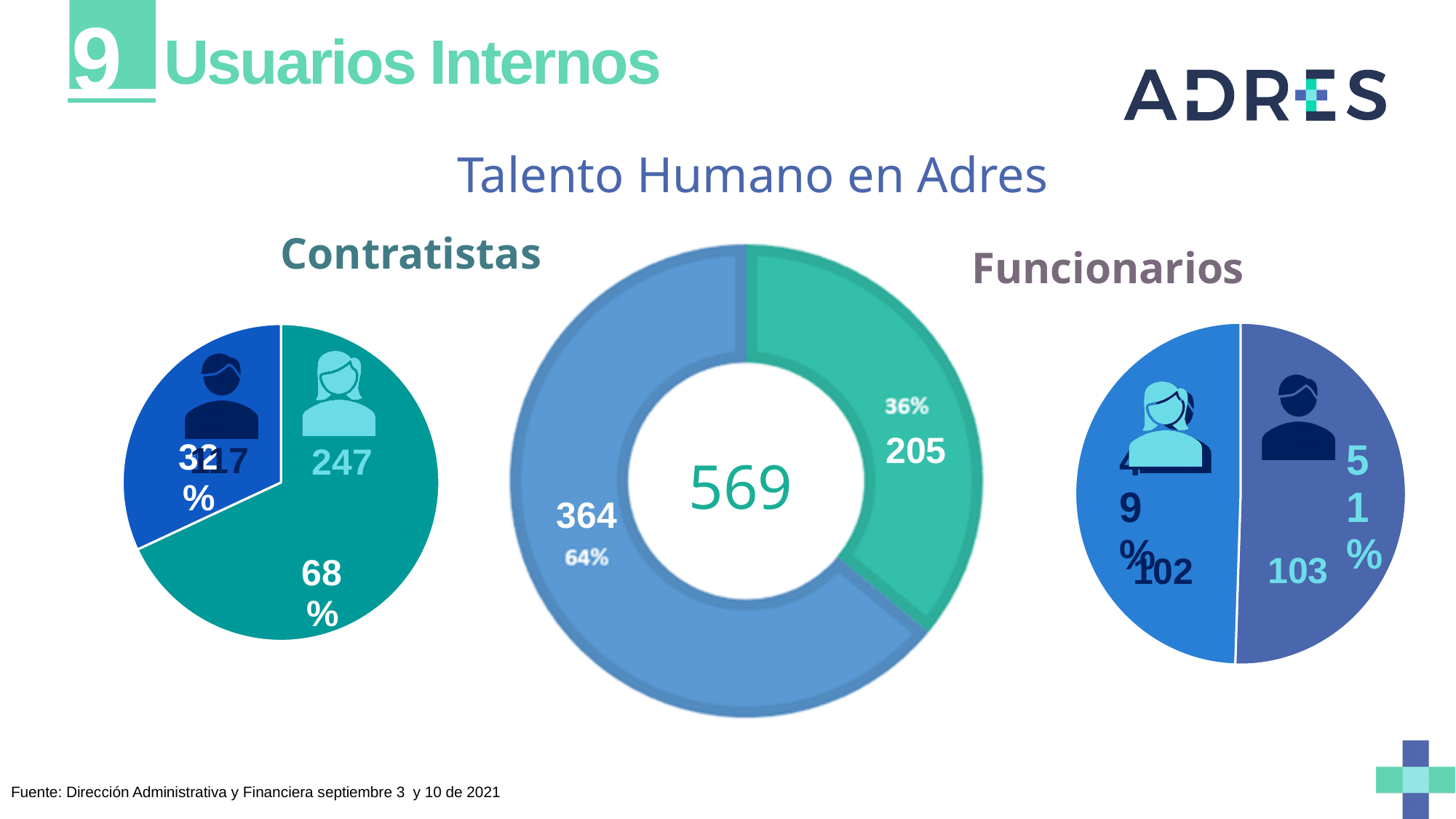
On the 'Contratistas' pie chart on the left, what percentage is labelled on the larger teal slice? 68% On the central donut chart, what percentage is labelled on the green segment? 36% On the central donut chart, how many segments are there? 2 On the 'Contratistas' pie chart on the left, which slice is larger, the teal slice or the dark blue slice? The teal slice On the 'Contratistas' pie chart on the left, what value is labelled on the larger teal slice? 247 On the 'Funcionarios' pie chart on the right, what percentage is labelled on the right-hand dark blue slice? 51% On the central donut chart, what is the difference between the blue segment (364) and the green segment (205)? 159 On the central donut chart titled 'Talento Humano en Adres', what total is shown in the centre? 569 On the 'Funcionarios' pie chart on the right, what is the difference between the two slices (103 and 102)? 1 What kind of chart is the central chart titled 'Talento Humano en Adres'? Donut (pie) chart On the 'Funcionarios' pie chart on the right, what value is labelled on the right-hand dark blue slice? 103 On the central donut chart, what value is labelled on the larger blue segment? 364